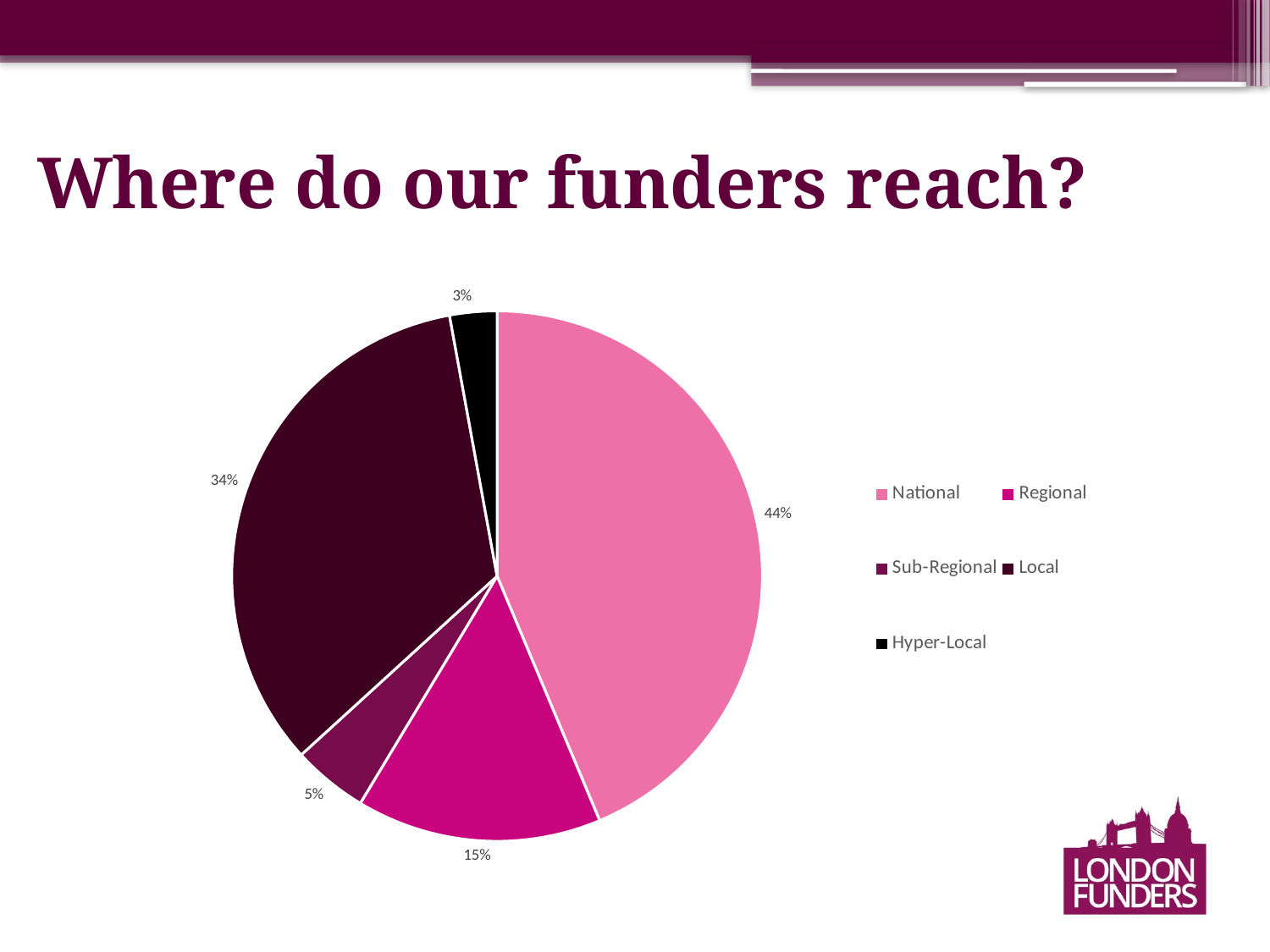
What kind of chart is shown on the slide? pie chart What is the title of the slide containing the chart? Where do our funders reach? What share of the pie does National represent? 44% What share of the pie does Local represent? 34% Which category has the smallest slice of the pie? Hyper-Local Which is larger, the Regional slice or the Sub-Regional slice? Regional How many categories does the pie chart have? 5 What share of the pie does Regional represent? 15% What is the difference in percentage points between National and Local? 10 Which category has the largest slice of the pie? National